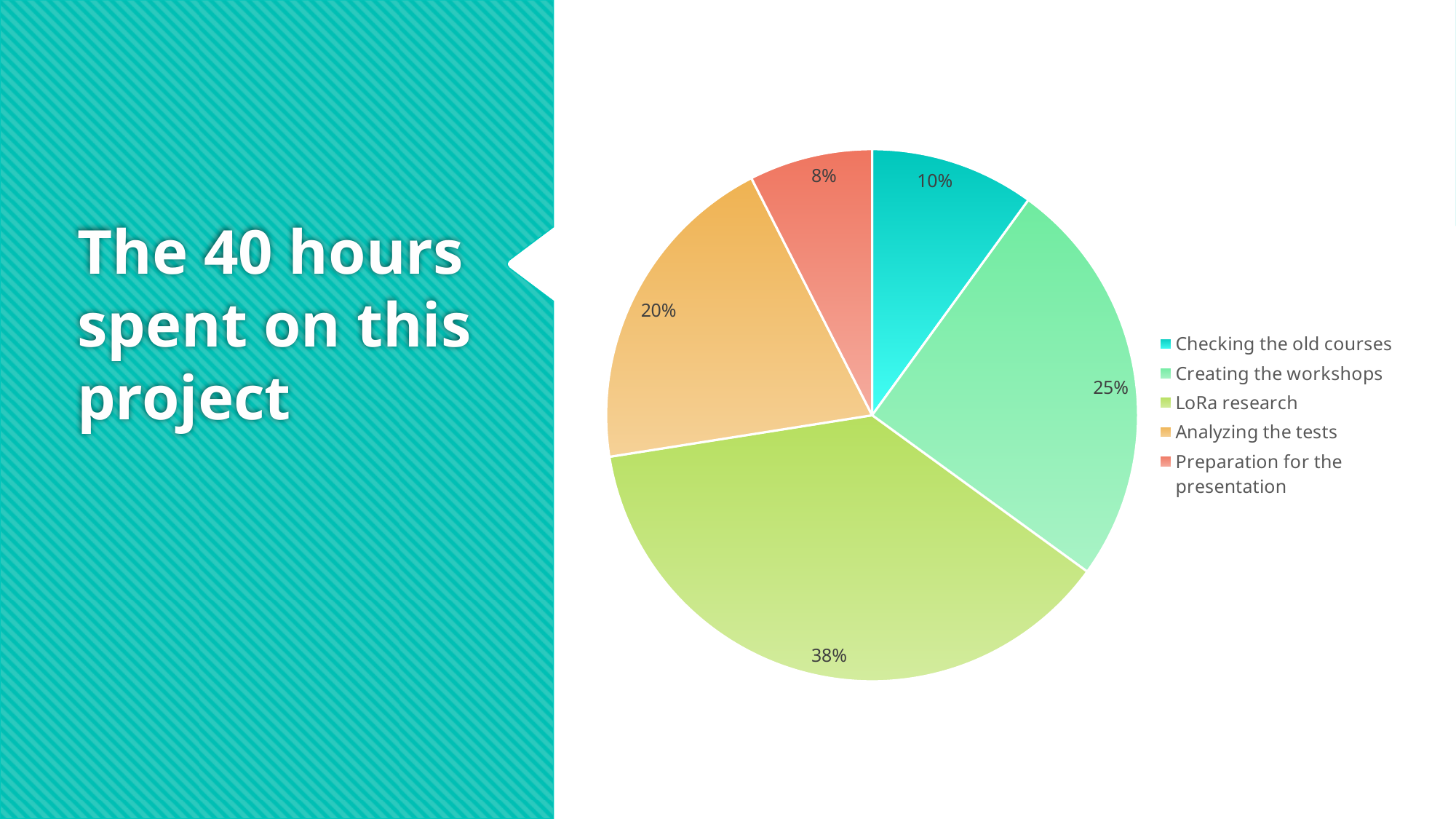
What percentage is shown for Preparation for the presentation? 8% Which category has the largest slice of the pie? LoRa research What is the difference in percentage points between LoRa research and Creating the workshops? 13 What is the title text on the left of the slide? The 40 hours spent on this project What percentage is shown for Creating the workshops? 25% Which category has the smallest slice of the pie? Preparation for the presentation How many categories does the pie chart have? 5 What share of the pie does LoRa research take? 38% What kind of chart is shown on the slide? pie chart What percentage is shown for Analyzing the tests? 20% Which is larger, the slice for Analyzing the tests or the slice for Checking the old courses? Analyzing the tests What percentage is shown for Checking the old courses? 10%